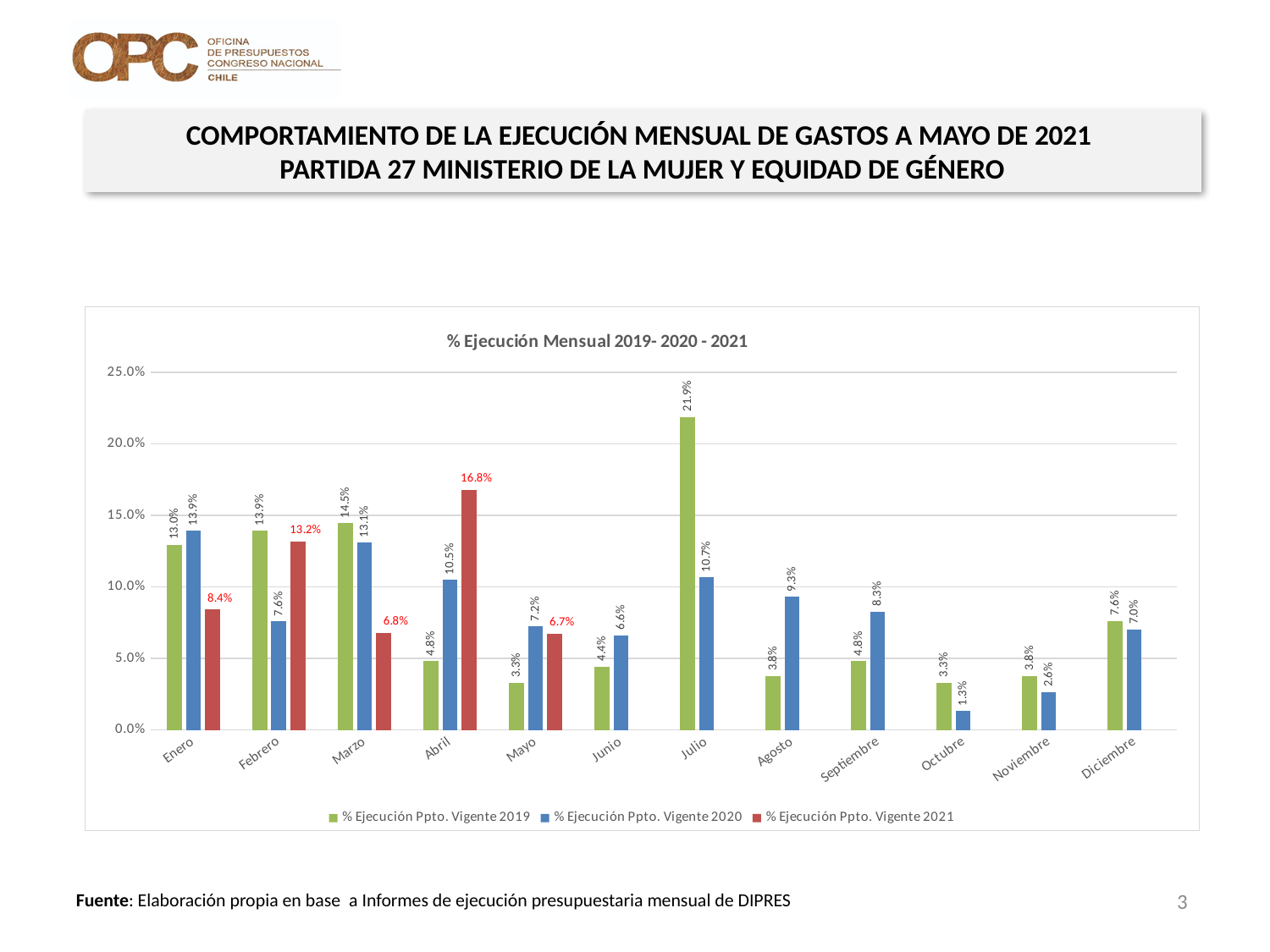
Which is larger in Enero: the 2019 value or the 2020 value? 2020 What is the title of the chart? % Ejecución Mensual 2019- 2020 - 2021 Which month has the highest value for % Ejecución Ppto. Vigente 2019? Julio What is the value for % Ejecución Ppto. Vigente 2020 in Julio? 10.7% How many series does the legend list? 3 What kind of chart is shown? Bar chart How many months have a value plotted for % Ejecución Ppto. Vigente 2021? 5 Which month has the lowest value for % Ejecución Ppto. Vigente 2020? Octubre What is the value for % Ejecución Ppto. Vigente 2021 in Abril? 16.8% What is the difference between the 2021 and 2019 values in Abril? 12.0% What is the total of the three series values in Mayo? 17.2% What is the value for % Ejecución Ppto. Vigente 2019 in Marzo? 14.5%